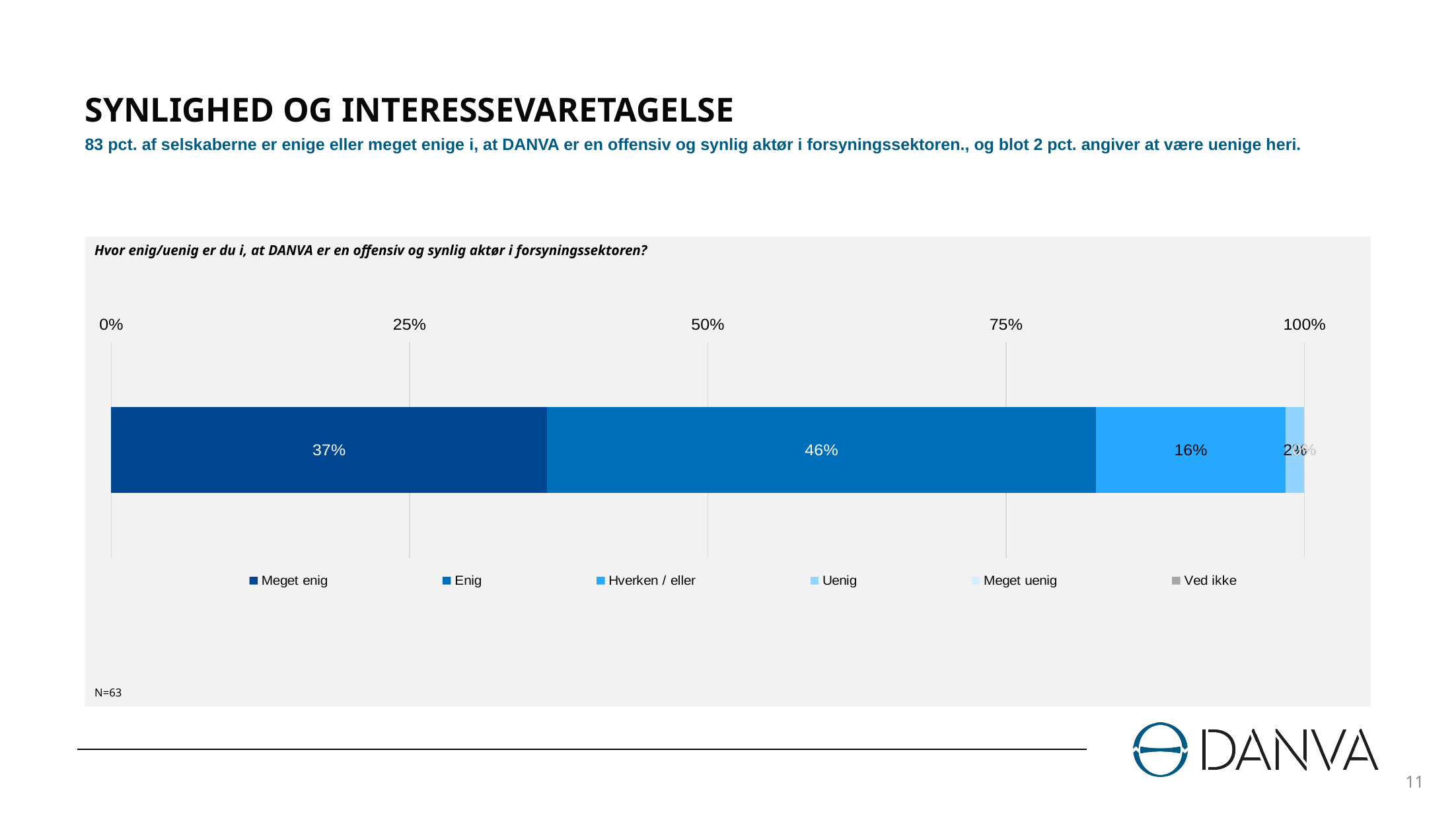
Which is larger, the share for "Meget enig" or the share for "Hverken / eller"? Meget enig What kind of chart is shown on the slide? Stacked bar chart What percentage of respondents answered "Enig"? 46% What percentage of respondents answered "Hverken / eller"? 16% Is the value for "Hverken / eller" greater or less than 25%? less How many series does the legend list? 6 What is the sample size (N) stated below the chart? N=63 What is the difference in percentage points between "Enig" and "Meget enig"? 9 percentage points What is the combined share of "Meget enig" and "Enig"? 83% Which response category has the largest share of the bar? Enig What percentage of respondents answered "Meget enig"? 37% Is the value for "Meget enig" greater or less than 25%? greater